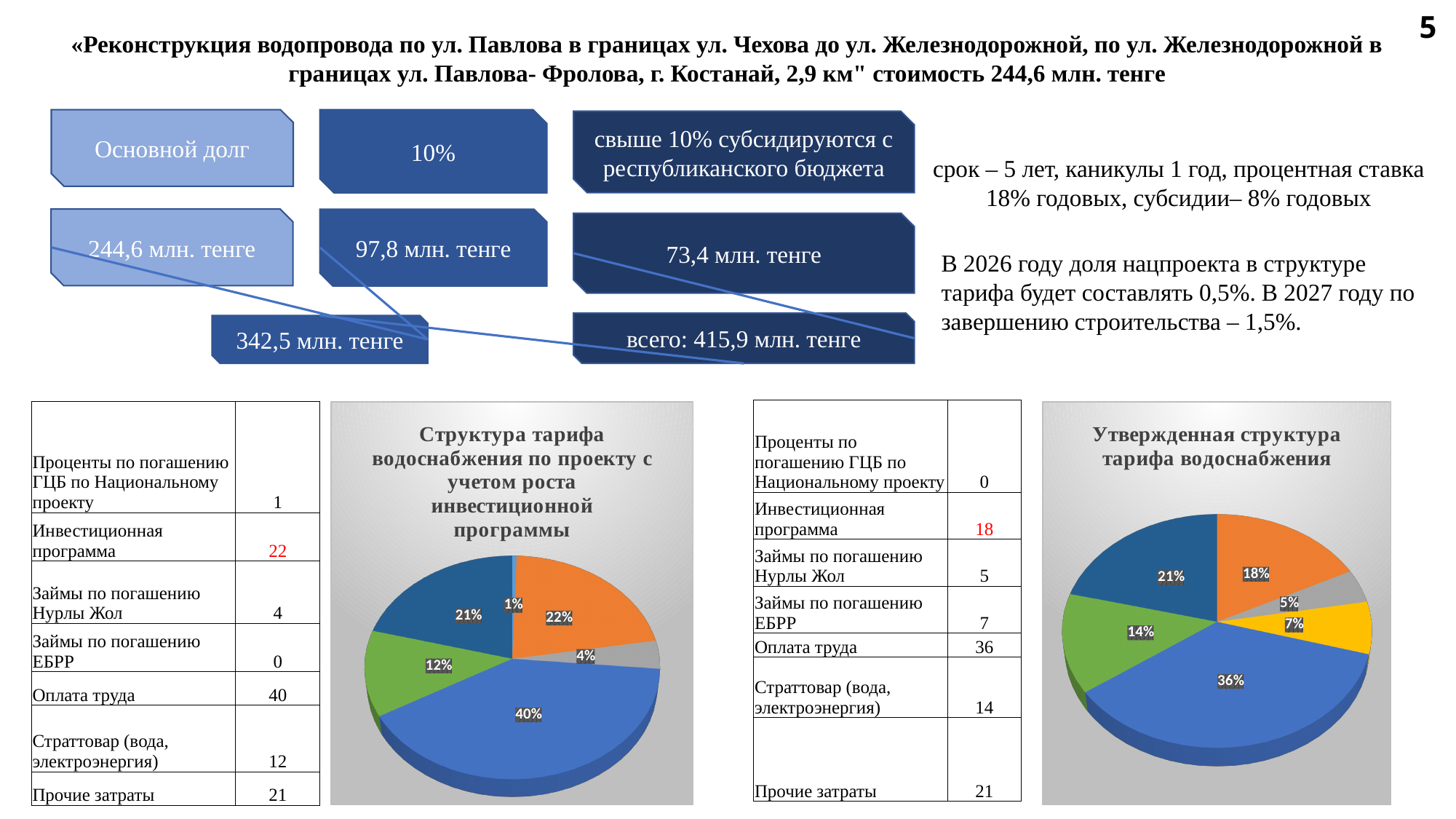
In the left pie chart «Структура тарифа водоснабжения по проекту...», what is the value of the smallest labelled slice? 1% In the right pie chart «Утвержденная структура тарифа водоснабжения», what is the value of the yellow slice? 7% In the right pie chart «Утвержденная структура тарифа водоснабжения», what is the value of the largest slice? 36% What kind of chart is the right chart titled «Утвержденная структура тарифа водоснабжения»? pie chart How many labelled slices does the left pie chart «Структура тарифа водоснабжения по проекту...» have? 6 In the left pie chart «Структура тарифа водоснабжения по проекту...», what is the value of the largest slice? 40% In the right pie chart «Утвержденная структура тарифа водоснабжения», what is the value of the smallest slice? 5% How many slices does the right pie chart «Утвержденная структура тарифа водоснабжения» have? 6 In the left pie chart «Структура тарифа водоснабжения по проекту...», which is larger: the orange slice or the green slice? the orange slice (22%) In the right pie chart «Утвержденная структура тарифа водоснабжения», what is the difference between the largest slice (36%) and the 21% slice? 15% In the left pie chart «Структура тарифа водоснабжения по проекту...», what is the value of the gray slice? 4% What kind of chart is the left chart titled «Структура тарифа водоснабжения по проекту с учетом роста инвестиционной программы»? pie chart